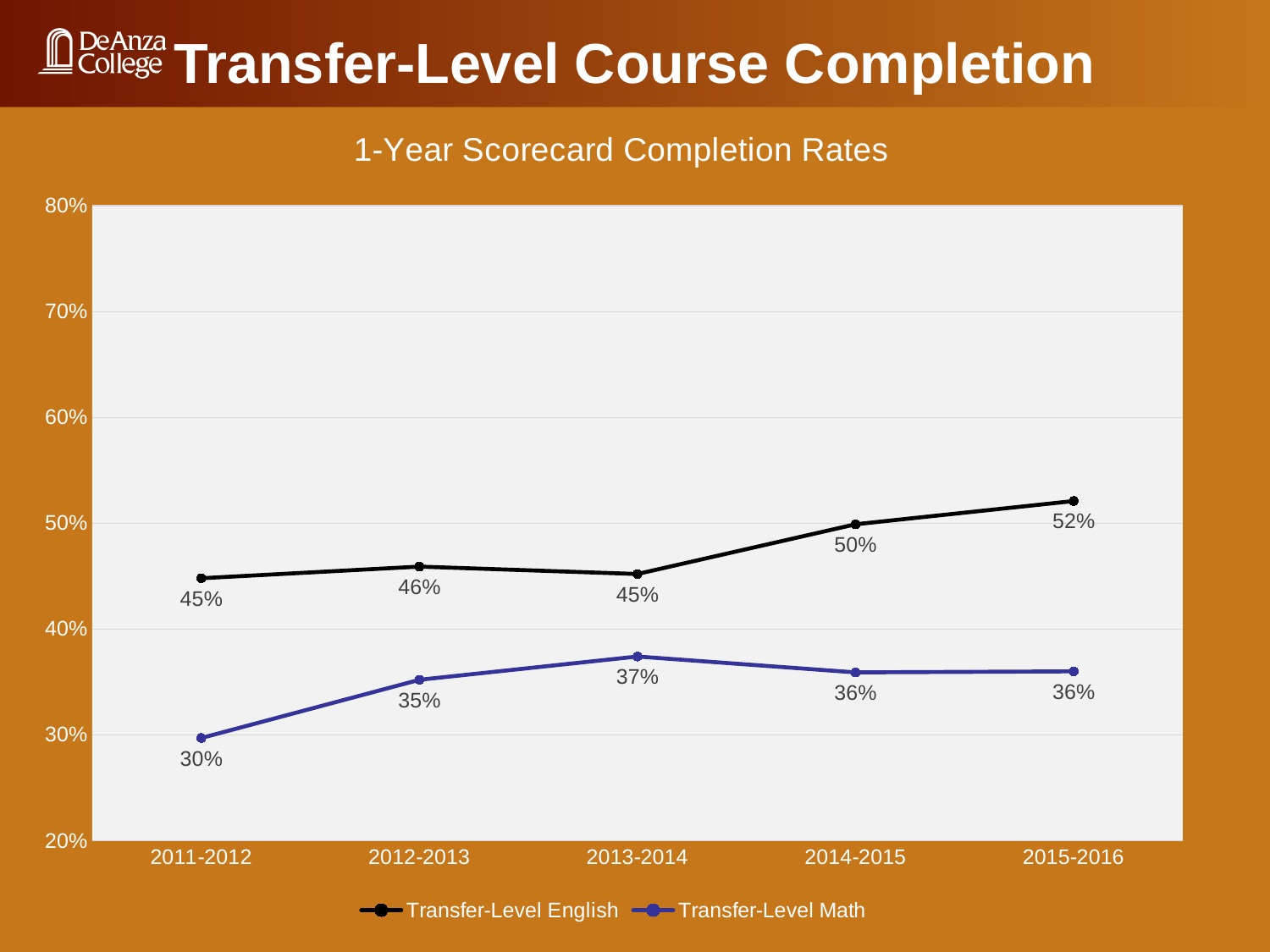
What is the Transfer-Level Math completion rate for 2011-2012? 30% How many series does the legend list? 2 In which year is the Transfer-Level English completion rate highest? 2015-2016 By how much did the Transfer-Level English rate change from 2011-2012 to 2015-2016? 7% What is the title of the chart? 1-Year Scorecard Completion Rates Which series has the higher completion rate in 2012-2013, Transfer-Level English or Transfer-Level Math? Transfer-Level English What is the difference between the Transfer-Level English and Transfer-Level Math rates in 2014-2015? 14% What is the Transfer-Level Math completion rate for 2013-2014? 37% In which year is the Transfer-Level Math completion rate lowest? 2011-2012 What is the Transfer-Level English completion rate for 2015-2016? 52% What kind of chart is shown on the slide? Line chart How many academic years are shown on the x axis? 5